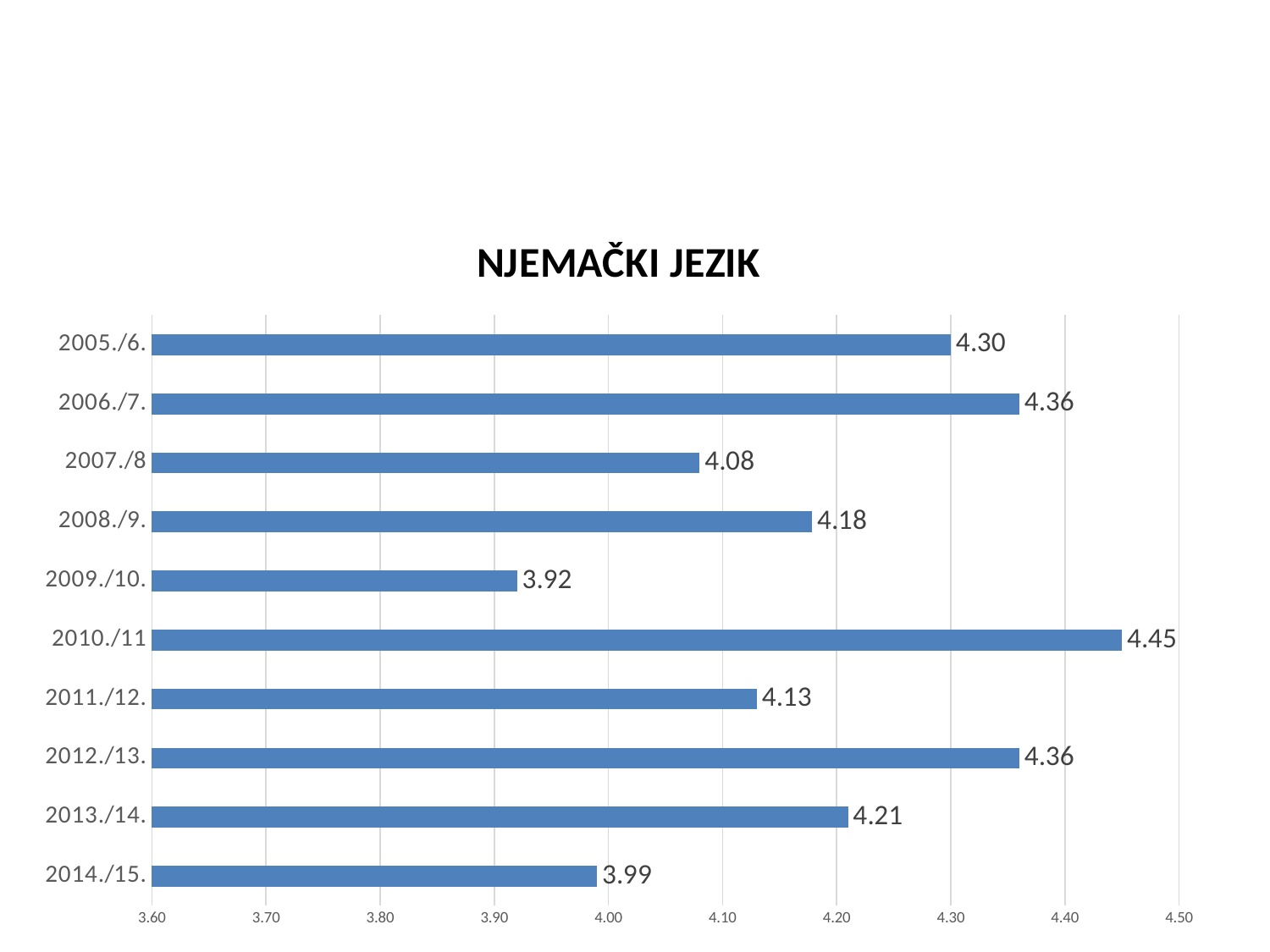
What is the difference between the values for 2006./7. and 2007./8? 0.28 How many school years are shown in the chart? 10 What is the title of the chart? NJEMAČKI JEZIK What is the value for 2014./15.? 3.99 What is the value for 2009./10.? 3.92 Which school year has the lowest value? 2009./10. What is the difference between the values for 2010./11 and 2009./10.? 0.53 What is the value for 2010./11? 4.45 Is the value for 2007./8 greater or less than 4.00? greater Which school year has the highest value? 2010./11 What kind of chart is shown on the slide? bar chart Which is larger, the value for 2005./6. or the value for 2013./14.? 2005./6.